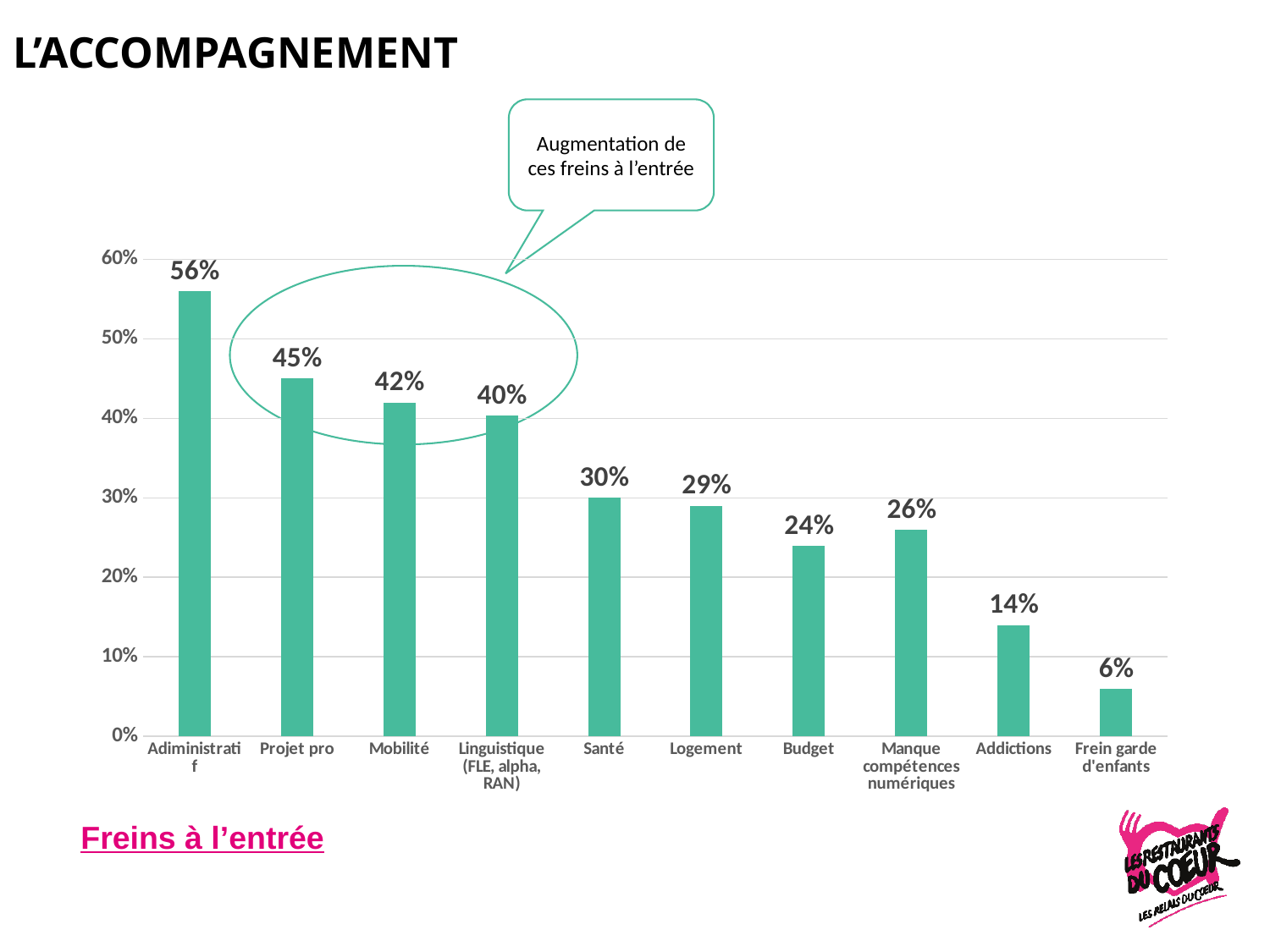
What is the value for Administratif? 56% What is the difference between the values for Projet pro and Mobilité? 3% What is the value for Addictions? 14% What is the value for Linguistique (FLE, alpha, RAN)? 40% Which category has the lowest value? Frein garde d'enfants Which category has the highest value? Administratif What is the value for Manque compétences numériques? 26% How many categories are shown on the x axis? 10 What kind of chart is this? bar chart What does the callout bubble above the chart say? Augmentation de ces freins à l'entrée Which is larger, the value for Budget or the value for Manque compétences numériques? Manque compétences numériques Is the value for Santé greater or less than 20%? greater